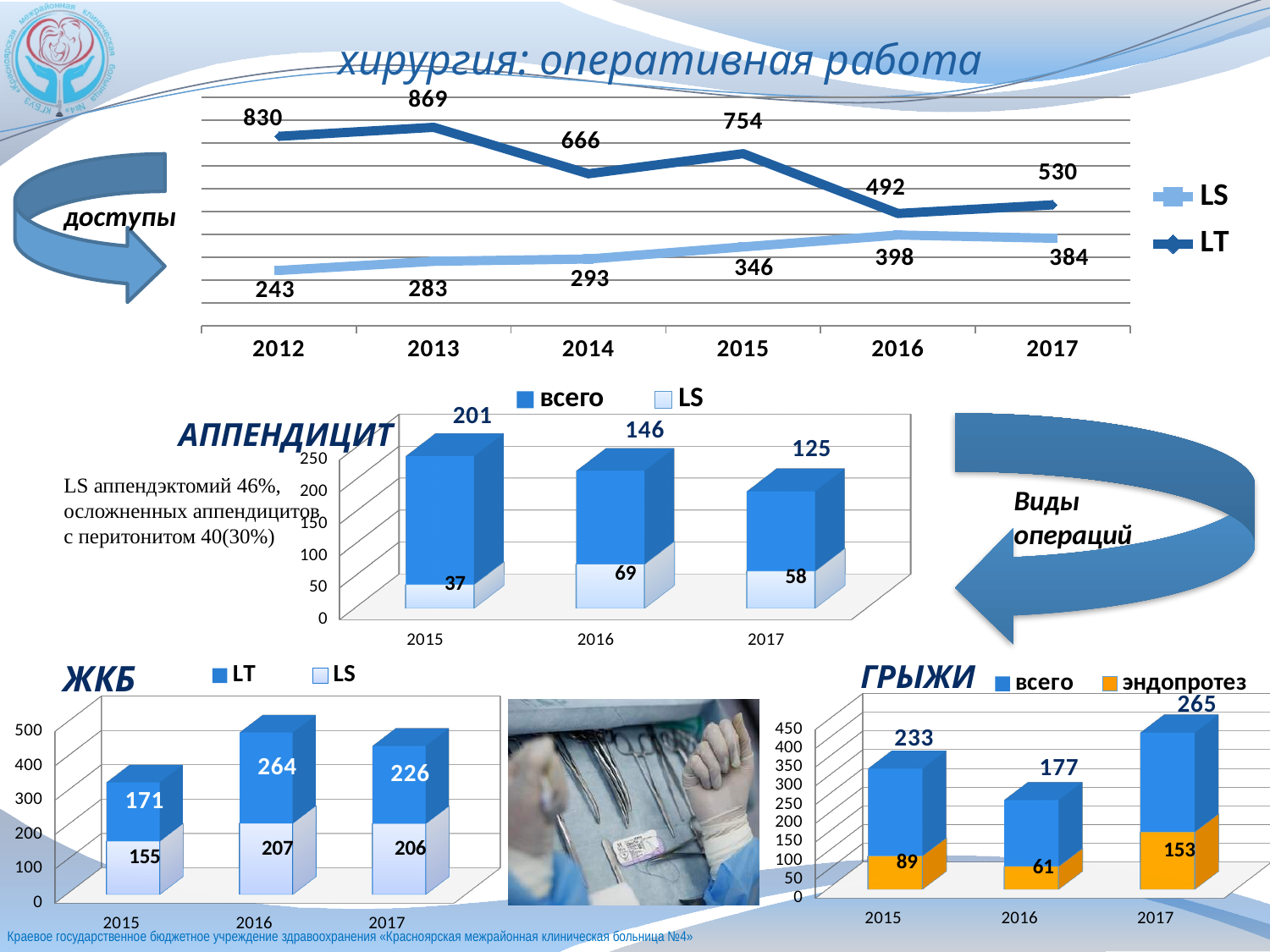
On the line chart at the top of the slide, what is the LS value for 2016? 398 On the line chart at the top of the slide, in which year is the LS value lowest? 2012 On the line chart at the top of the slide, in which year is the LT value highest? 2013 On the АППЕНДИЦИТ chart, what is the LS value for 2015? 37 On the ГРЫЖИ chart, which year has the highest всего value? 2017 How many series does the legend of the line chart at the top of the slide list? 2 On the line chart at the top of the slide, what is the LT value for 2013? 869 On the line chart at the top of the slide, what is the difference between the LT and LS values in 2012? 587 What kind of chart is the chart at the top of the slide showing LS and LT from 2012 to 2017? line chart On the ГРЫЖИ chart, what is the эндопротез value for 2017? 153 On the АППЕНДИЦИТ chart, what is the всего value for 2016? 146 On the ЖКБ chart, what is the total of the stacked bar for 2016 (LT plus LS)? 471